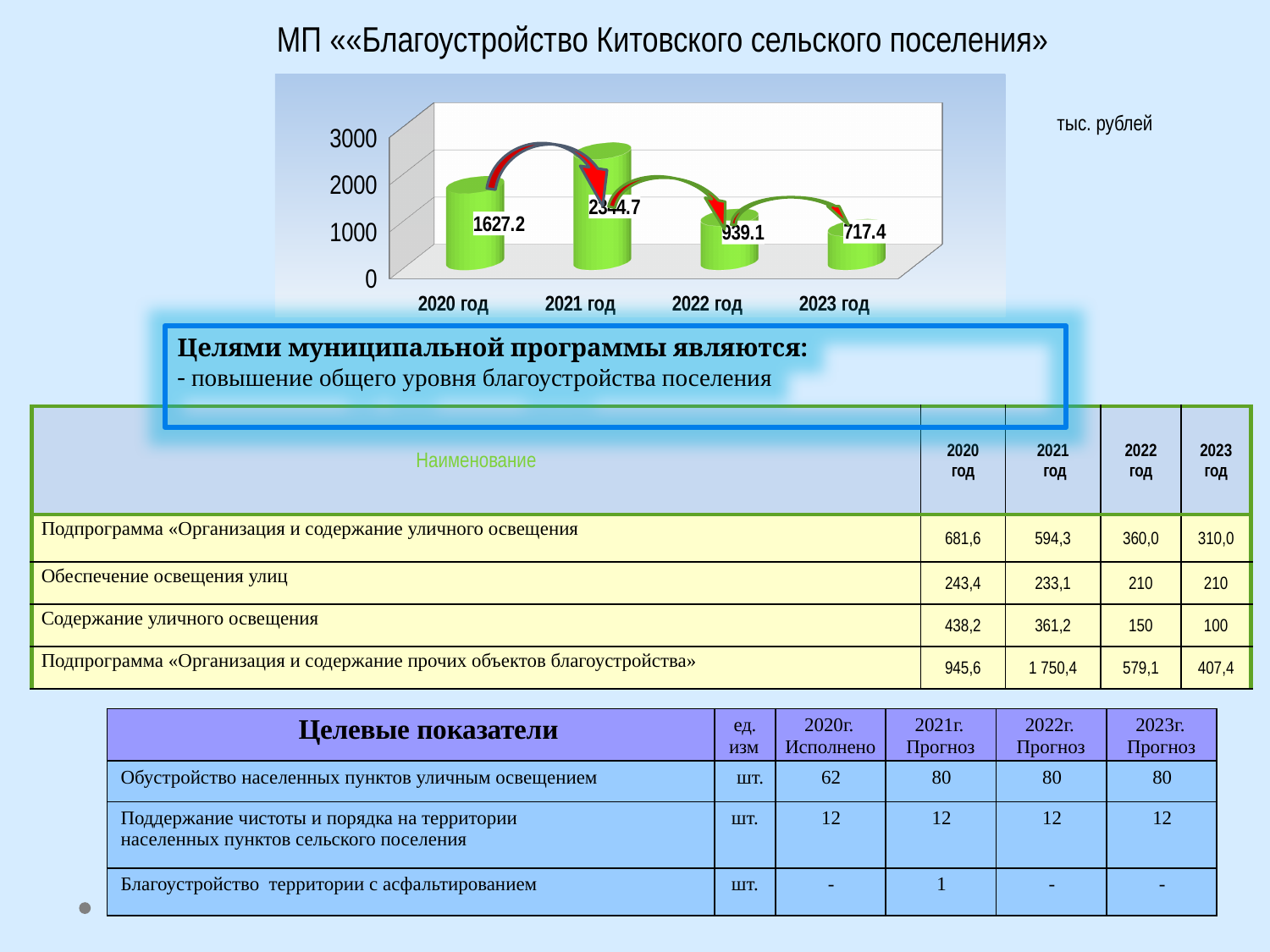
Which year has the lowest value? 2023 год What is the value for 2023 год? 717.4 Which is larger, the value for 2020 год or the value for 2022 год? 2020 год Is the value for 2021 год greater or less than 2000? greater What is the difference between the values for 2022 год and 2023 год? 221.7 Which year has the highest value? 2021 год How many years are shown on the chart? 4 Do the values rise or fall from 2021 год to 2023 год? fall What is the difference between the values for 2020 год and 2022 год? 688.1 What is the value for 2022 год? 939.1 What kind of chart is shown on the slide? bar chart What is the value for 2020 год? 1627.2